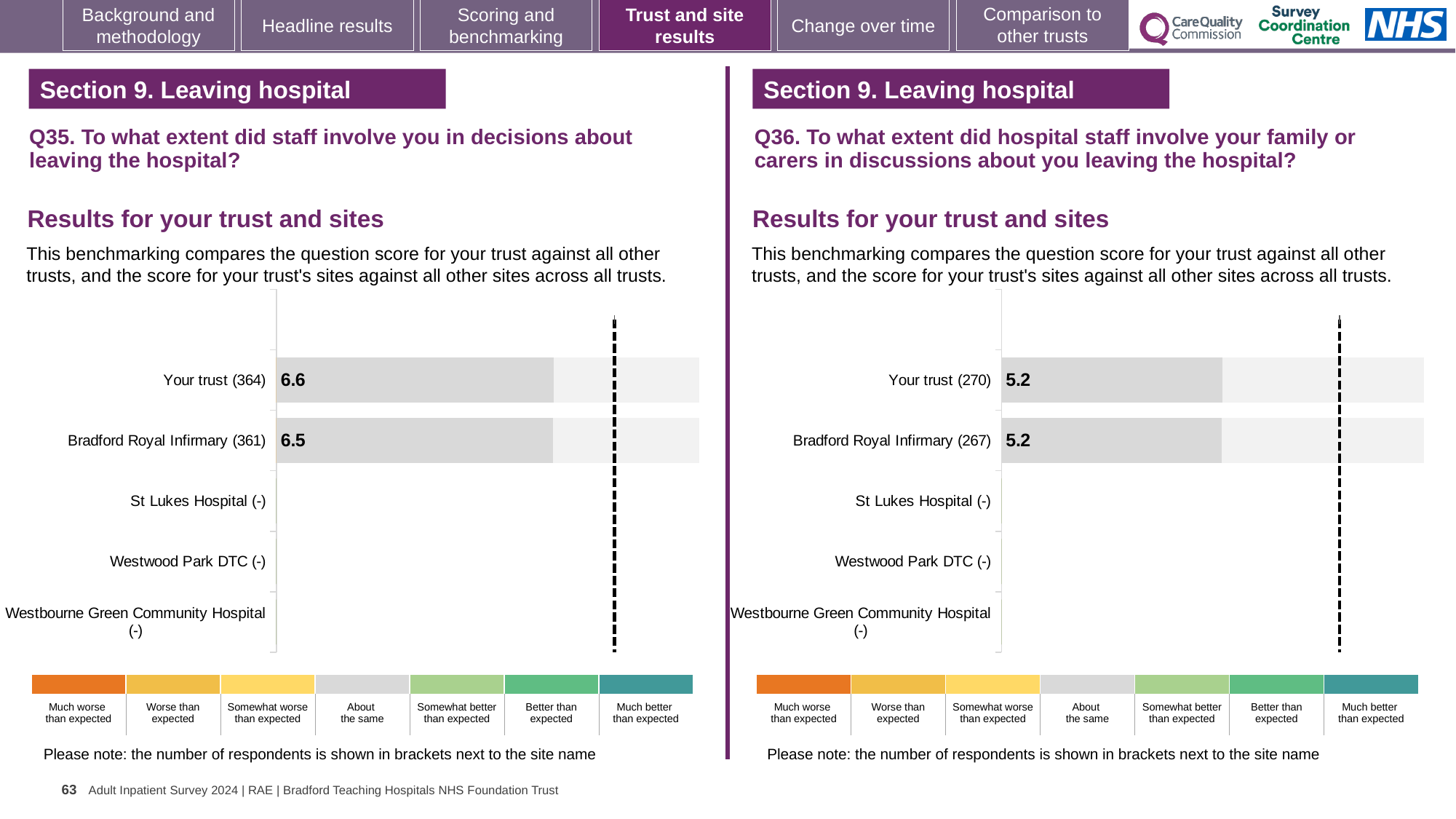
How many site/trust categories are listed on the y axis of the Q35 chart on the left? 5 In the Q36 chart on the right, what is the score for Bradford Royal Infirmary? 5.2 What kind of chart is the Q36 chart on the right? Bar chart In the Q36 chart on the right, which category has the larger score, Your trust or Bradford Royal Infirmary? They are equal (both 5.2) How many colour bands does the legend below each chart show, from 'Much worse than expected' to 'Much better than expected'? 7 In the Q35 chart on the left, how many respondents are shown in brackets for Your trust? 364 In the Q36 chart on the right, what is the score for Your trust? 5.2 In the Q36 chart on the right, how many respondents are shown in brackets for Bradford Royal Infirmary? 267 In the Q35 chart on the left, what is the score for Your trust? 6.6 In the Q35 chart on the left, what is the score for Bradford Royal Infirmary? 6.5 In the Q35 chart on the left, which category has the highest score? Your trust (364) In the Q35 chart on the left, what is the difference between the score for Your trust and the score for Bradford Royal Infirmary? 0.1